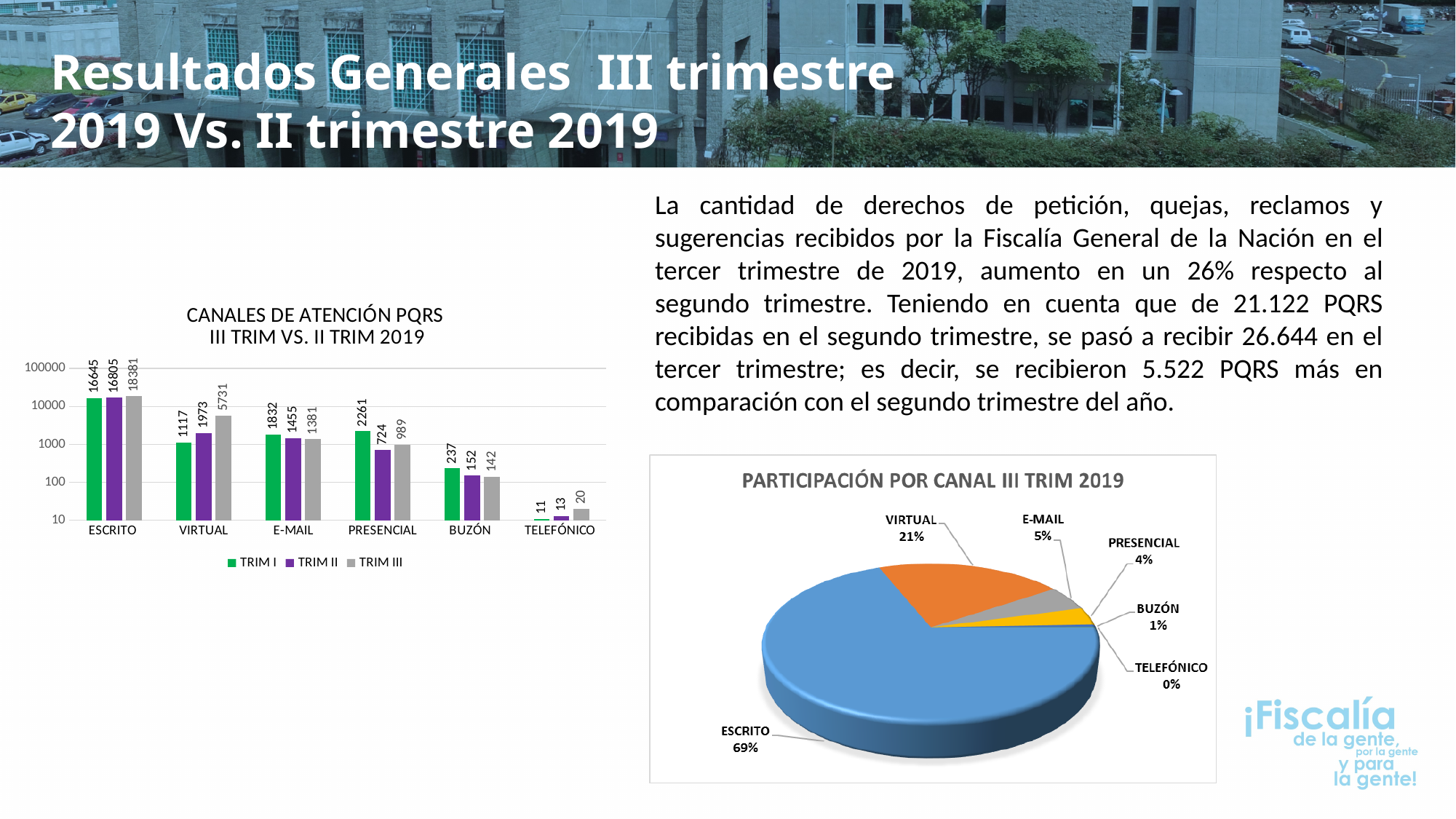
In the bar chart 'CANALES DE ATENCIÓN PQRS III TRIM VS. II TRIM 2019', which category has the lowest TRIM I value? TELEFÓNICO In the bar chart 'CANALES DE ATENCIÓN PQRS III TRIM VS. II TRIM 2019', which series is shown in green? TRIM I How many categories are shown on the x axis of the bar chart 'CANALES DE ATENCIÓN PQRS III TRIM VS. II TRIM 2019'? 6 What kind of chart is 'PARTICIPACIÓN POR CANAL III TRIM 2019'? Pie chart In the bar chart 'CANALES DE ATENCIÓN PQRS III TRIM VS. II TRIM 2019', what is the TRIM III value for VIRTUAL? 5731 In the bar chart 'CANALES DE ATENCIÓN PQRS III TRIM VS. II TRIM 2019', which is larger for E-MAIL: the TRIM I value or the TRIM III value? TRIM I How many series does the legend of the bar chart 'CANALES DE ATENCIÓN PQRS III TRIM VS. II TRIM 2019' list? 3 In the bar chart 'CANALES DE ATENCIÓN PQRS III TRIM VS. II TRIM 2019', which category has the highest TRIM III value? ESCRITO In the pie chart 'PARTICIPACIÓN POR CANAL III TRIM 2019', which channel has the largest share? ESCRITO In the bar chart 'CANALES DE ATENCIÓN PQRS III TRIM VS. II TRIM 2019', what is the TRIM II value for PRESENCIAL? 724 In the pie chart 'PARTICIPACIÓN POR CANAL III TRIM 2019', what share does VIRTUAL have? 21% In the bar chart 'CANALES DE ATENCIÓN PQRS III TRIM VS. II TRIM 2019', what is the difference between the TRIM III and TRIM II values for ESCRITO? 1576